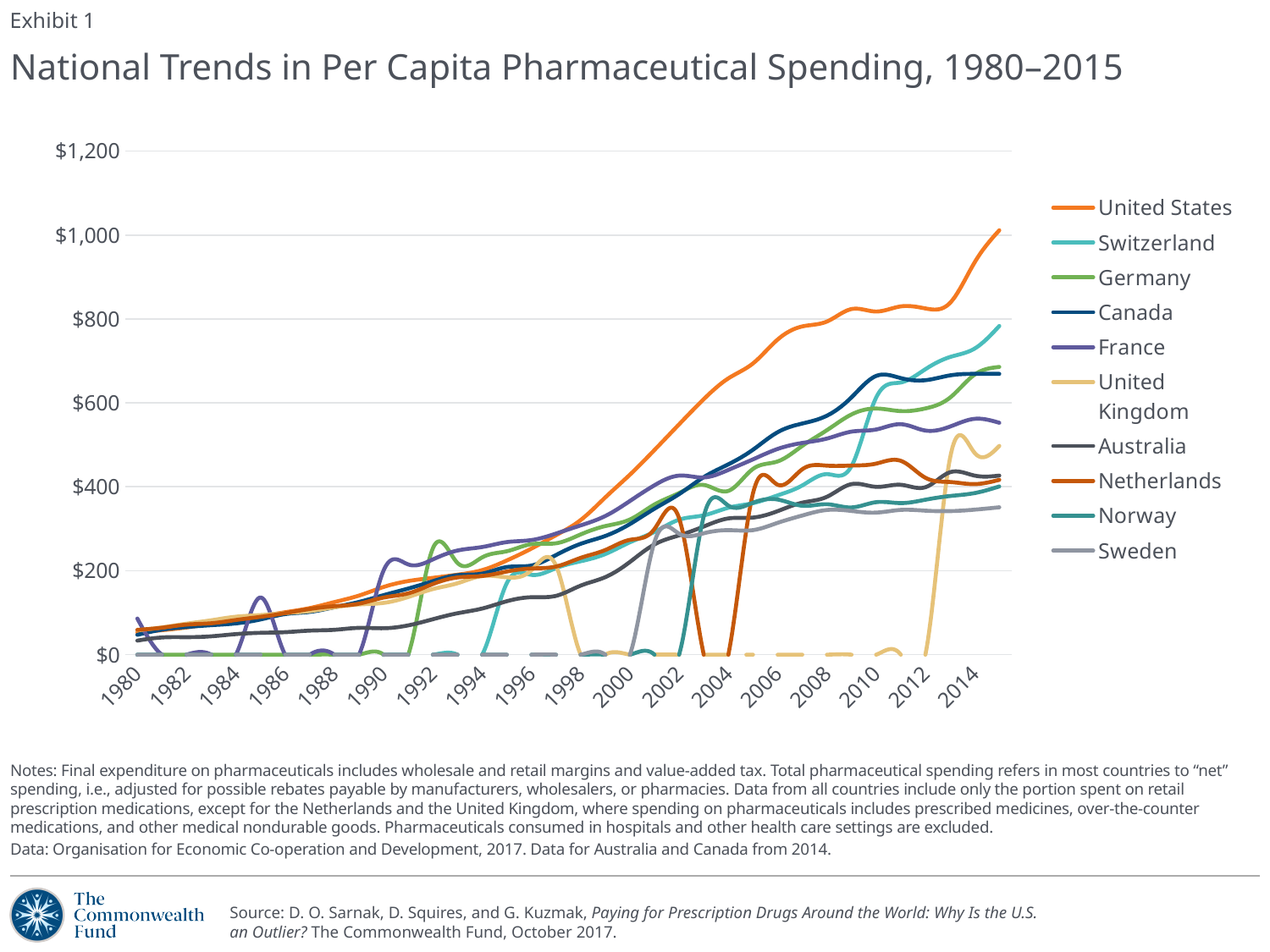
Which country has the highest per capita pharmaceutical spending at the end of the period (2015)? United States Which country is listed first in the legend? United States Does the United States line generally rise or fall from 1980 to 2015? Rise What is the title of the chart? National Trends in Per Capita Pharmaceutical Spending, 1980–2015 Which is larger in 2014, the value for the United States or the value for Canada? United States How many series does the legend list? 10 Which country has the lowest per capita pharmaceutical spending at the end of the period (2015)? Sweden What kind of chart is shown on the slide? Line chart Is the value for Germany in 2014 greater or less than $600? greater Is the value for Sweden in 2014 greater or less than $400? less How many year labels are shown on the x axis? 18 Is the value for the United States in 2014 greater or less than $800? greater